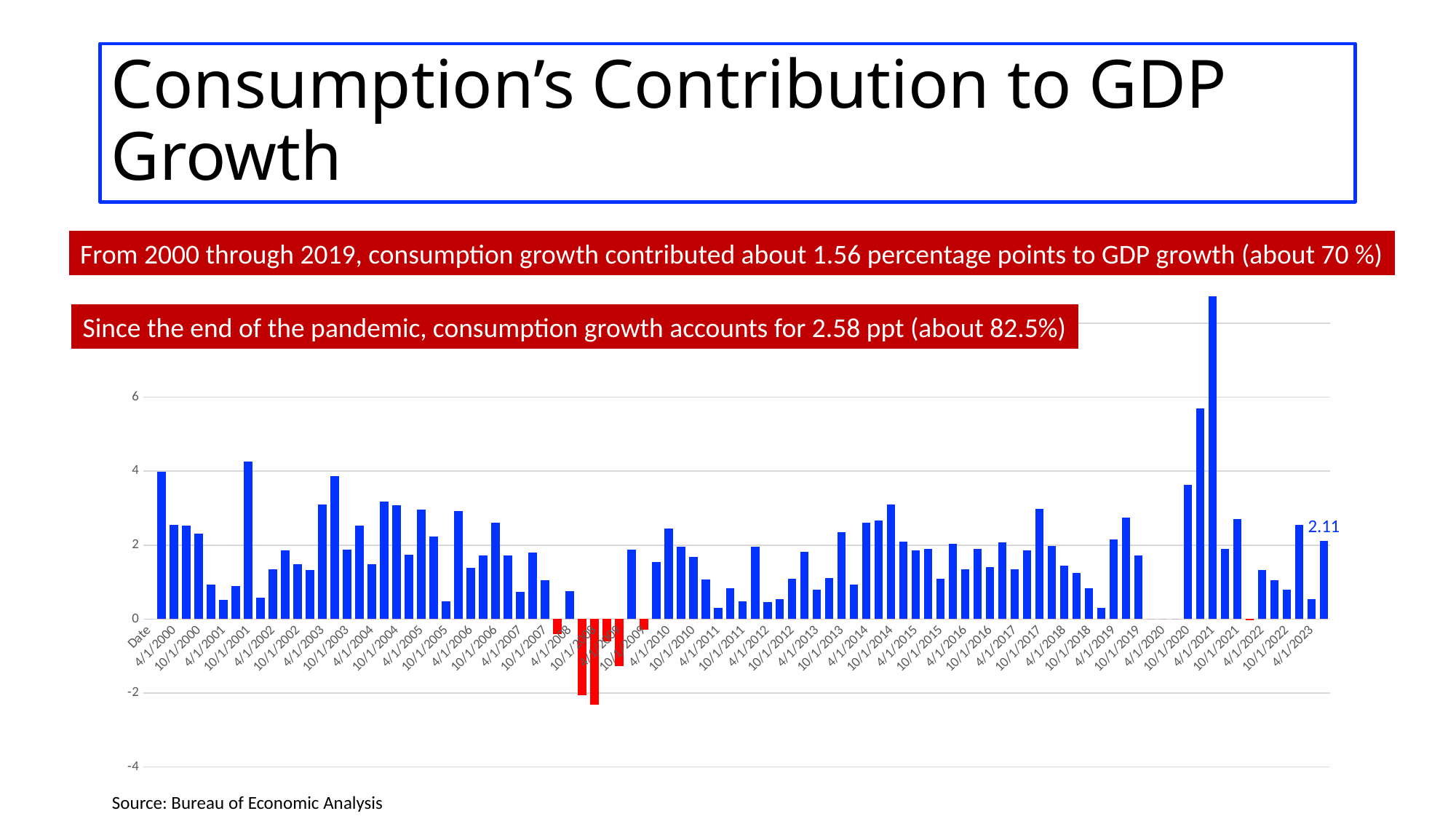
What kind of chart is shown on the slide? bar chart What value is printed as a data label on the rightmost bar of the chart? 2.11 Is the value of the bar at 4/1/2001 greater or less than 2? less Is the value of the bar at 10/1/2008 greater or less than 0? less Around which x-axis date does the tallest bar in the chart occur? 4/1/2021 Which bar is taller, the one at 4/1/2000 or the one at 4/1/2001? 4/1/2000 What colour are the bars with negative values in the chart? red Is the value of the bar at 10/1/2020 greater or less than 4? less Which bar is taller, the one at 4/1/2021 or the one at 10/1/2020? 4/1/2021 What is the source cited for the chart? Bureau of Economic Analysis